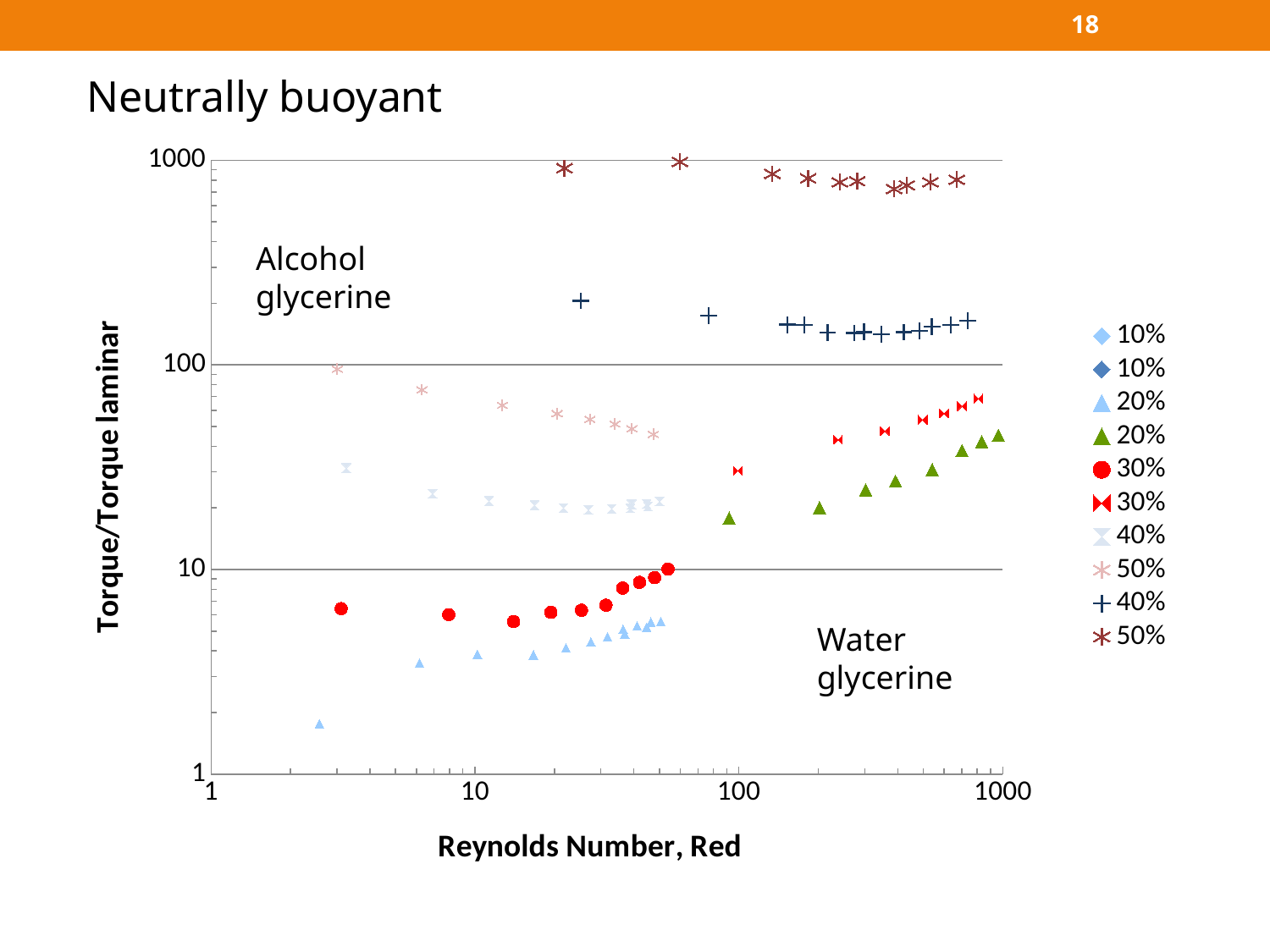
Are the values of the light blue triangle 20% series greater or less than 10? less Are the values of the dark red asterisk 50% series greater or less than 100? greater What is the title of the y axis? Torque/Torque laminar What kind of chart is shown on the slide? scatter chart Which series has the highest values on the chart? the dark red asterisk 50% series Which series contains the lowest point on the chart? the light blue triangle 20% series Do the values of the pink asterisk 50% series rise or fall as the Reynolds number increases? fall How many series does the legend list? 10 Are the values of the green triangle 20% series greater or less than 10? greater What is the title of the x axis? Reynolds Number, Red Do the values of the red circle 30% series rise or fall as the Reynolds number increases? rise